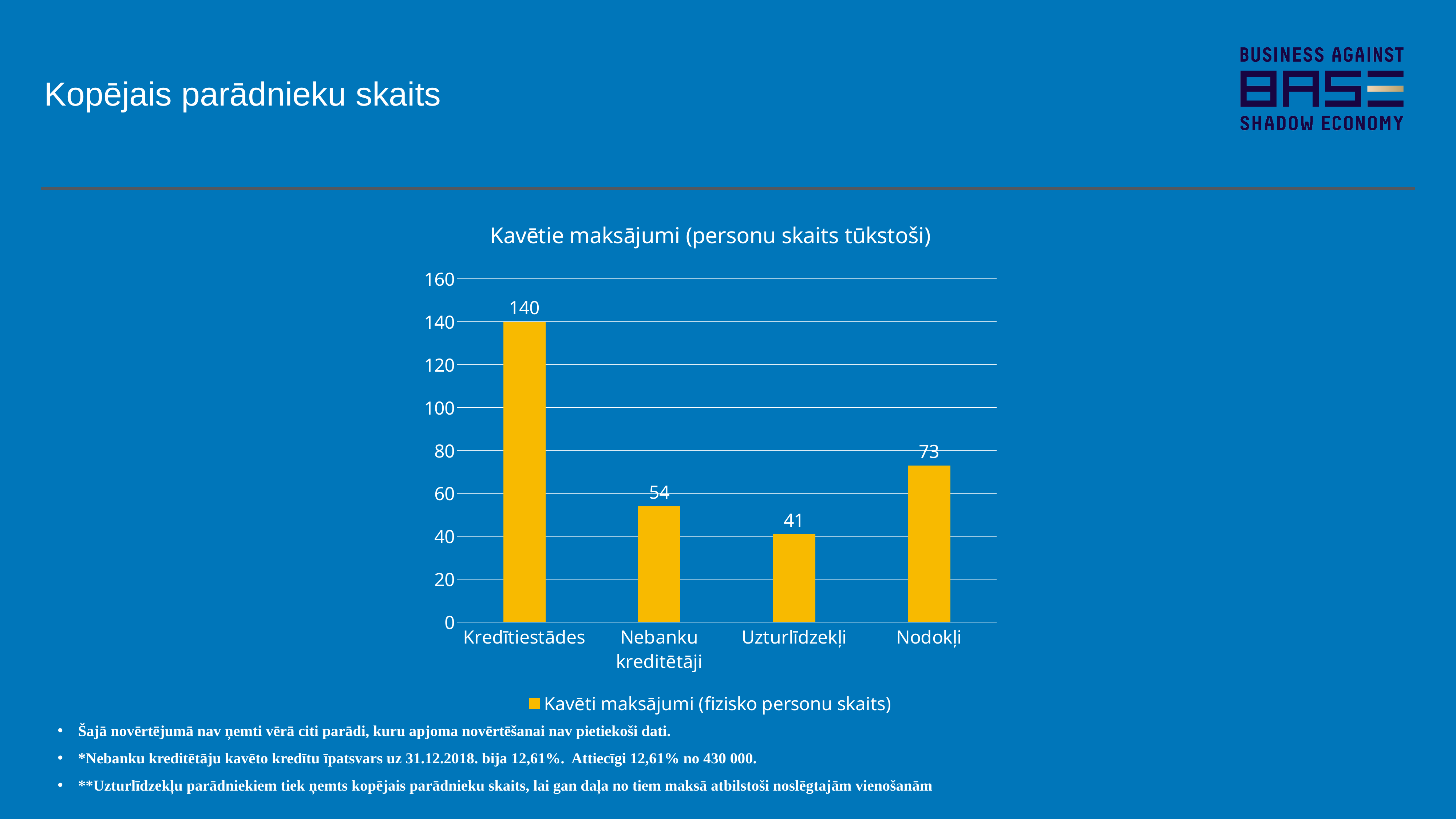
Which category has the highest value? Kredītiestādes What is the value for Nodokļi? 73 Which category has the lowest value? Uzturlīdzekļi Which is larger, the value for Nebanku kreditētāji or the value for Nodokļi? Nodokļi What is the value for Nebanku kreditētāji? 54 What kind of chart is shown on the slide? bar chart What is the difference between the values for Kredītiestādes and Nodokļi? 67 What is the value for Kredītiestādes? 140 What is the title of the chart? Kavētie maksājumi (personu skaits tūkstoši) What is the value for Uzturlīdzekļi? 41 Is the value for Nodokļi greater or less than 80? less How many categories are shown on the x axis? 4